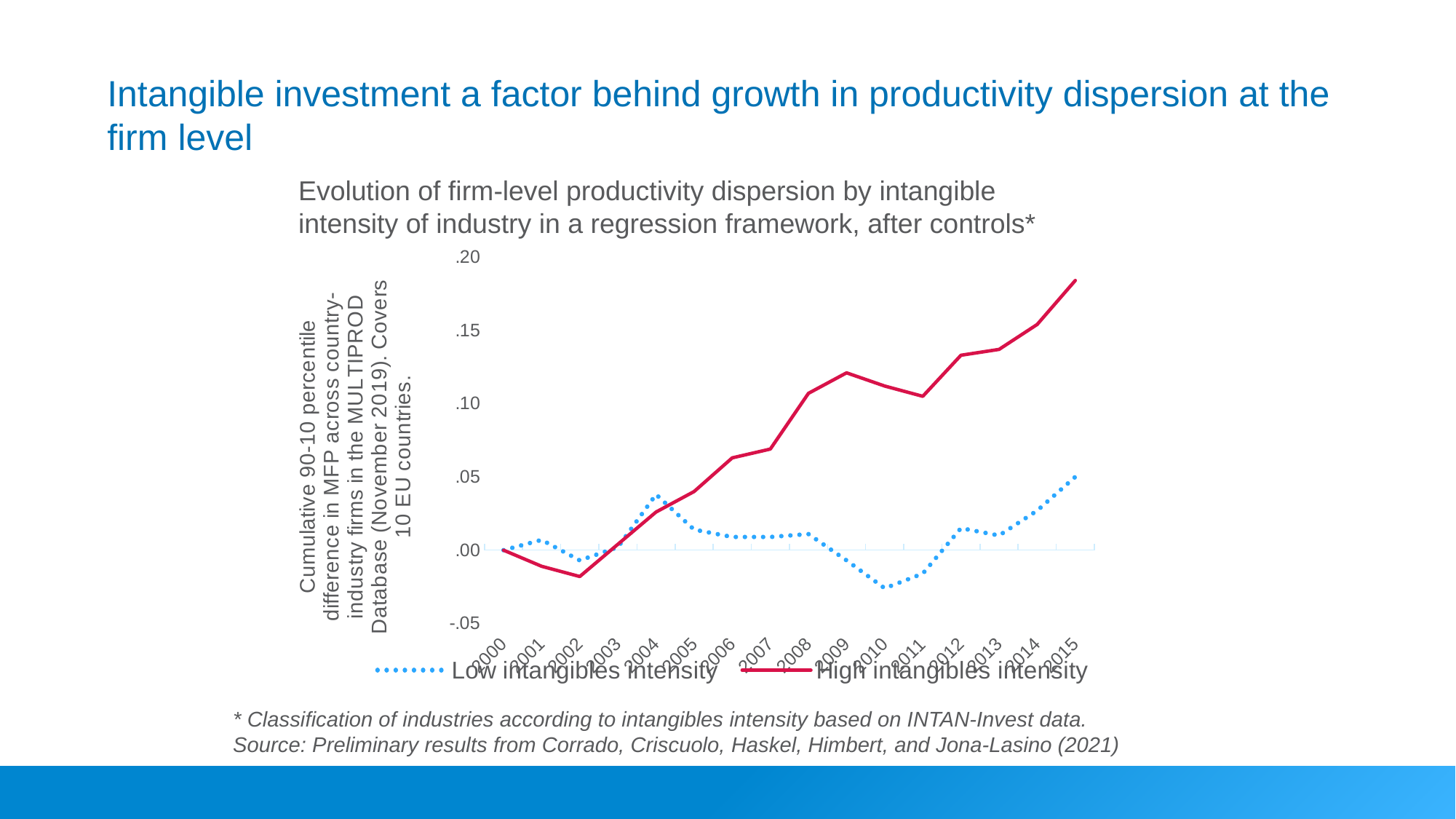
In which year does the High intangibles intensity series reach its highest value? 2015 Is the value for Low intangibles intensity in 2015 greater or less than .10? less How many series does the legend list? 2 Does the High intangibles intensity series generally rise or fall from 2002 to 2015? Rise What kind of chart is shown on the slide? Line chart In 2015, which series has the higher value, Low intangibles intensity or High intangibles intensity? High intangibles intensity Is the value for Low intangibles intensity in 2010 greater or less than .00? less What is the value of the High intangibles intensity series in 2000? .00 How many years are plotted along the x axis? 16 Is the value for High intangibles intensity in 2009 greater or less than .10? greater In which year does the Low intangibles intensity series reach its lowest value? 2010